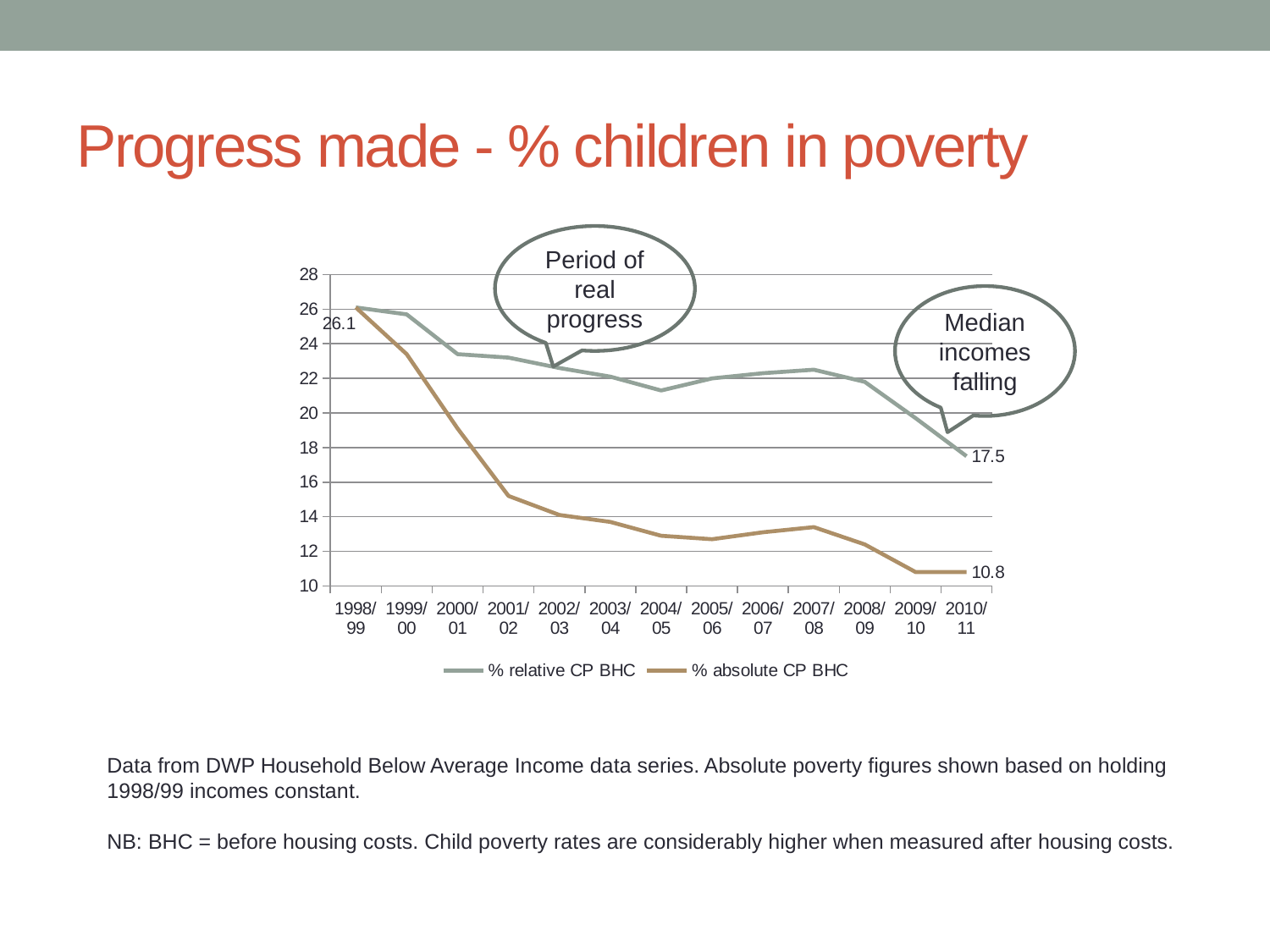
How many series does the legend list? 2 What is the difference between % relative CP BHC and % absolute CP BHC in 2010/11? 6.7 Do the values of % absolute CP BHC generally rise or fall from 1998/99 to 2010/11? fall What kind of chart is shown on the slide? line chart Which series has the larger value in 2010/11, % relative CP BHC or % absolute CP BHC? % relative CP BHC What is the value of % absolute CP BHC in 2010/11? 10.8 What value is labelled at the start of the lines in 1998/99? 26.1 In which year is % relative CP BHC at its lowest? 2010/11 What is the value of % relative CP BHC in 2010/11? 17.5 By how much did % relative CP BHC fall from 26.1 in 1998/99 to its 2010/11 value? 8.6 How many years are shown along the x axis? 13 Is the value for % absolute CP BHC in 2004/05 greater or less than 14? less